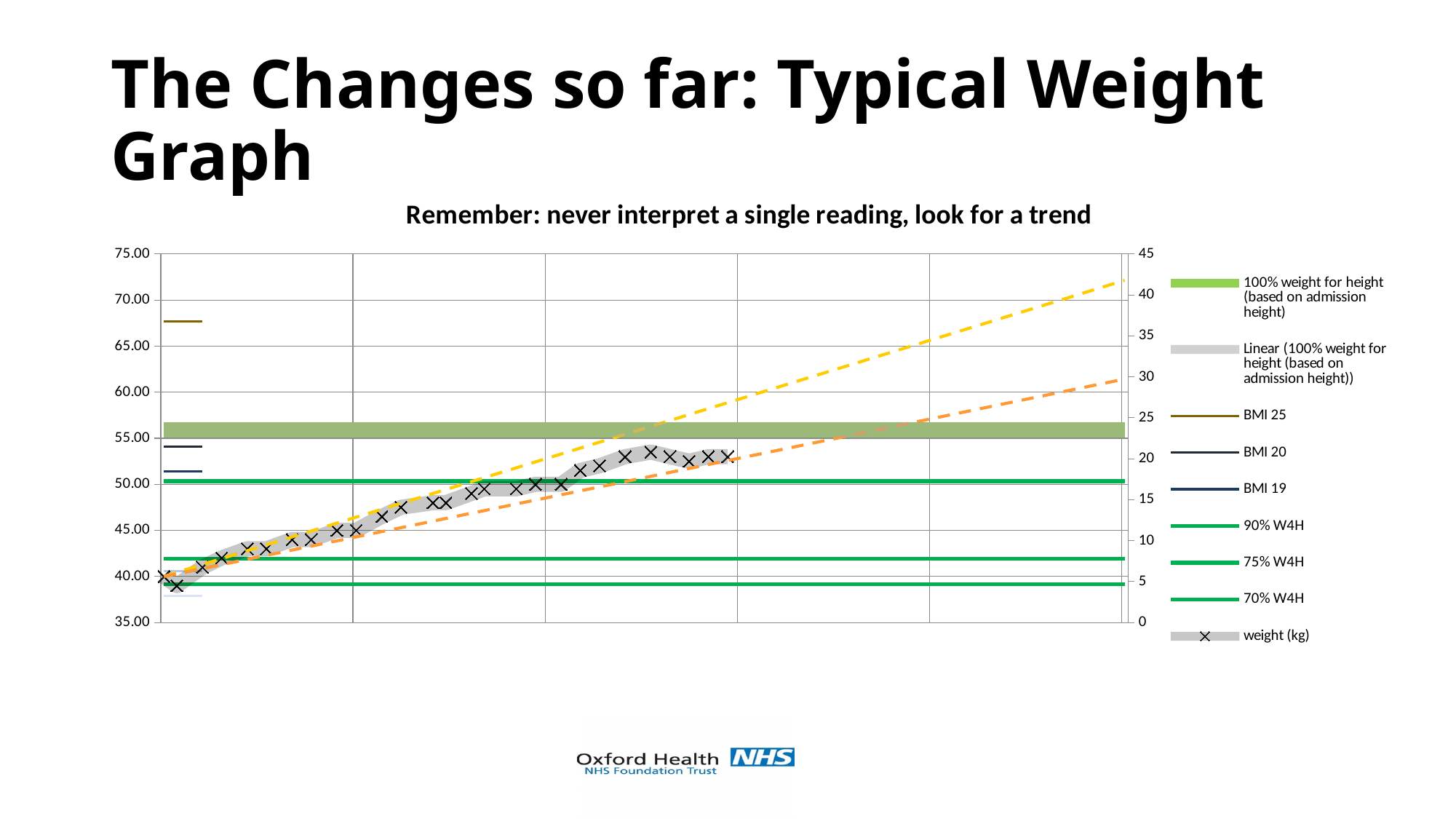
Is the 75% W4H line greater or less than 40 on the left axis? greater Is the 70% W4H line greater or less than 40 on the left axis? less Is the last weight (kg) reading greater or less than 50? greater What is the title of the chart? Remember: never interpret a single reading, look for a trend Which is higher on the chart, the 90% W4H line or the 75% W4H line? 90% W4H Which is larger, the first weight (kg) reading or the last weight (kg) reading? the last reading Which is higher on the chart, the BMI 25 line or the BMI 20 line? BMI 25 How many series does the chart legend list? 9 Does the weight (kg) series generally rise or fall along the x axis? rise What kind of chart is shown on the slide? line chart